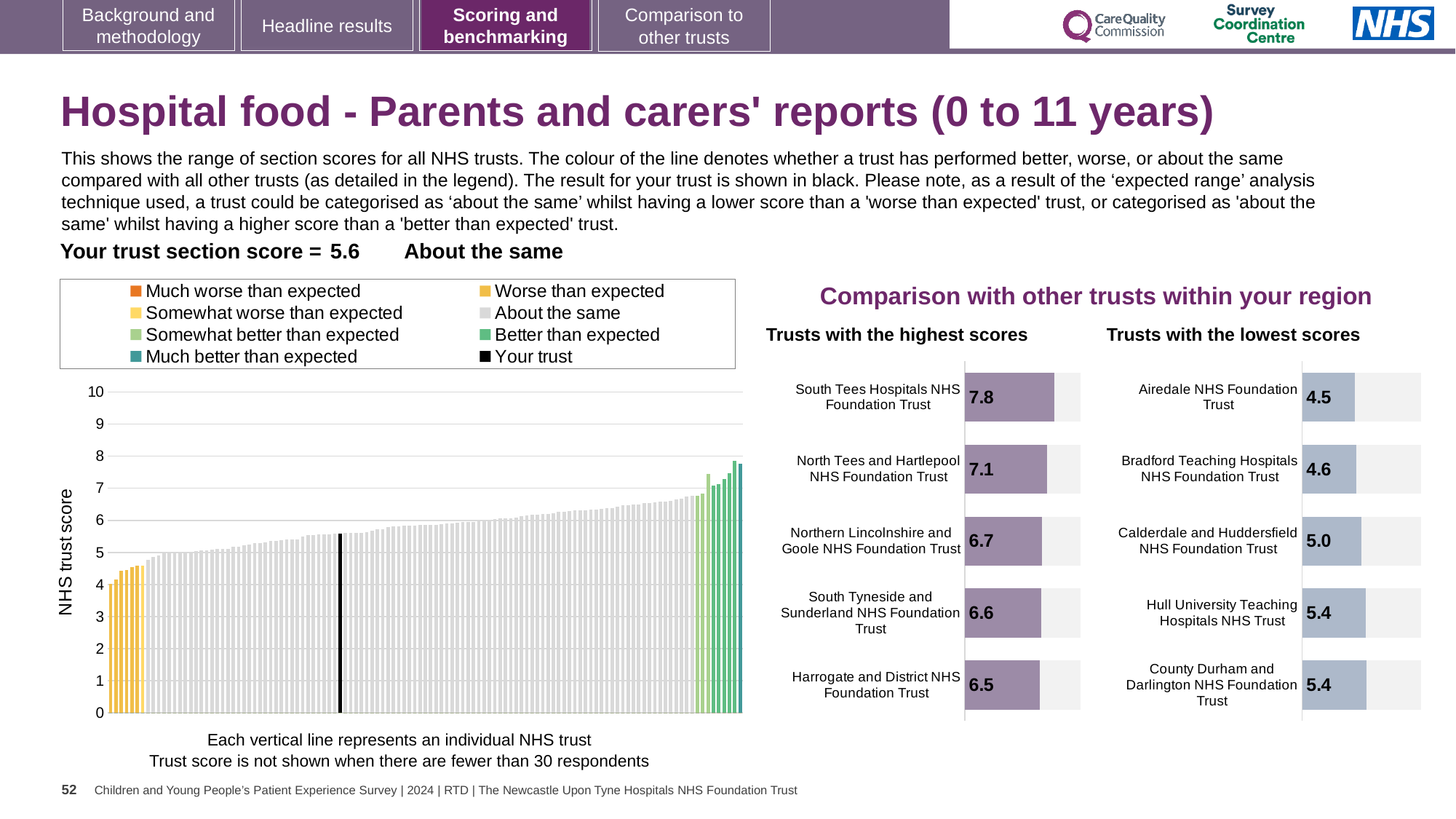
In the 'Trusts with the lowest scores' chart, which has the higher score: Bradford Teaching Hospitals NHS Foundation Trust or Calderdale and Huddersfield NHS Foundation Trust? Calderdale and Huddersfield NHS Foundation Trust In the 'Trusts with the highest scores' chart, which trust has the highest score? South Tees Hospitals NHS Foundation Trust What kind of chart is the large chart on the left showing NHS trust scores? Bar chart In the 'Trusts with the highest scores' chart, what is the difference between the scores of South Tees Hospitals NHS Foundation Trust and North Tees and Hartlepool NHS Foundation Trust? 0.7 How many entries does the legend of the large chart on the left list? 8 How many trusts are shown in the 'Trusts with the highest scores' chart? 5 In the large chart on the left, do the trust scores rise or fall from left to right? Rise In the 'Trusts with the lowest scores' chart, what is the score for Calderdale and Huddersfield NHS Foundation Trust? 5.0 In the 'Trusts with the highest scores' chart, what is the score for South Tees Hospitals NHS Foundation Trust? 7.8 In the 'Trusts with the lowest scores' chart, what is the difference between the scores of Hull University Teaching Hospitals NHS Trust and Airedale NHS Foundation Trust? 0.9 In the 'Trusts with the lowest scores' chart, which trust has the lowest score? Airedale NHS Foundation Trust In the 'Trusts with the highest scores' chart, what is the score for Harrogate and District NHS Foundation Trust? 6.5